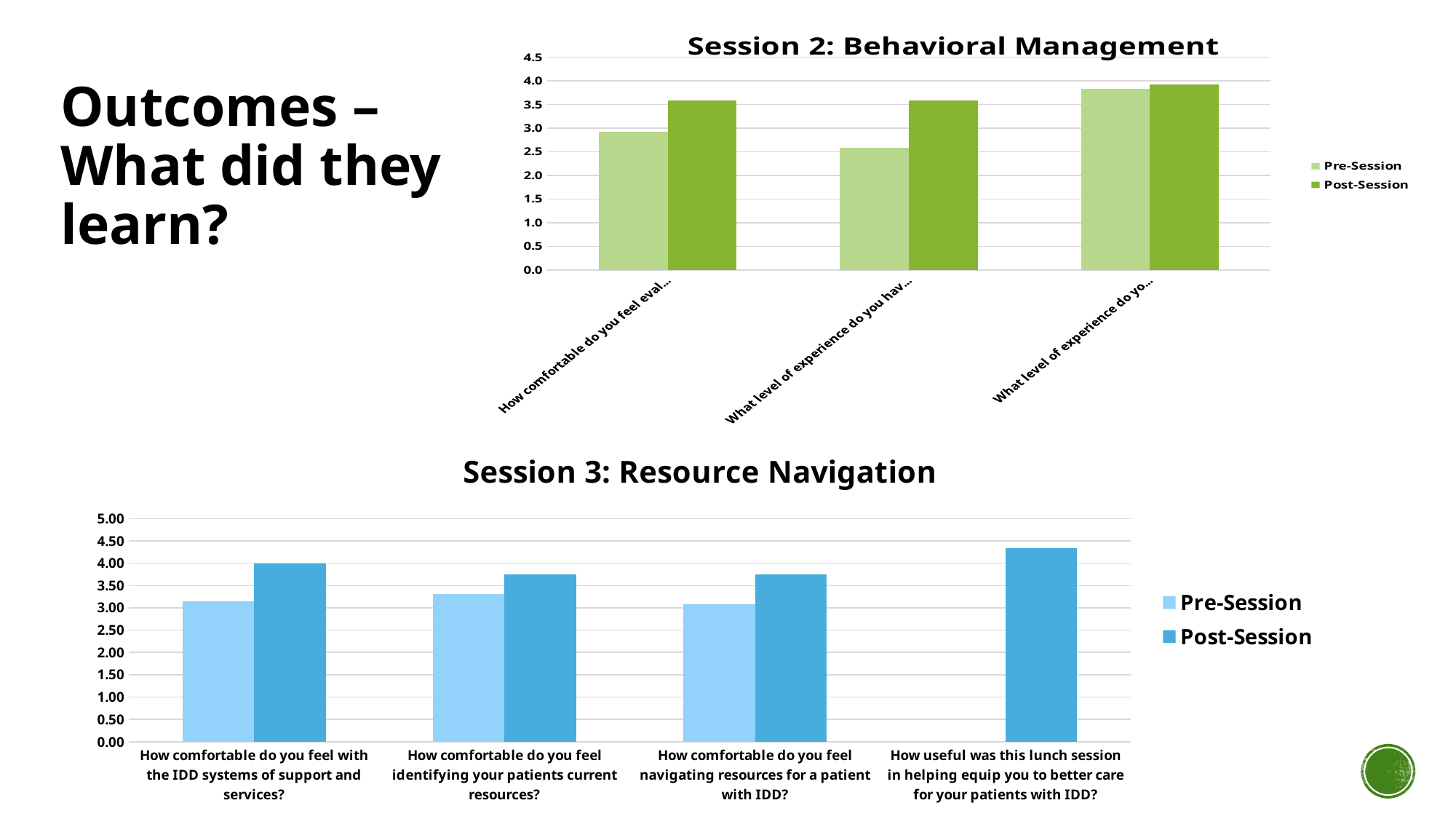
In the 'Session 2: Behavioral Management' chart, which category (by position) has the lowest Pre-Session value? the second category In the 'Session 3: Resource Navigation' chart, which legend entry is shown in the darker blue colour? Post-Session In the 'Session 2: Behavioral Management' chart, which category (by position) has the highest Pre-Session value? the third category How many question categories are shown on the x axis of the 'Session 2: Behavioral Management' chart? 3 In the 'Session 2: Behavioral Management' chart, is the Pre-Session value for the second category greater or less than 3.0? less How many series does the legend of the 'Session 2: Behavioral Management' chart list? 2 How many question categories are shown on the x axis of the 'Session 3: Resource Navigation' chart? 4 In the 'Session 3: Resource Navigation' chart, is the Post-Session value for 'How useful was this lunch session in helping equip you to better care for your patients with IDD?' greater or less than 4.00? greater In the 'Session 3: Resource Navigation' chart, is the Pre-Session value for 'How comfortable do you feel with the IDD systems of support and services?' greater or less than 3.50? less In the 'Session 3: Resource Navigation' chart, for 'How comfortable do you feel identifying your patients current resources?', which is larger: the Pre-Session or the Post-Session value? Post-Session What kind of chart is the 'Session 3: Resource Navigation' chart? bar chart In the 'Session 3: Resource Navigation' chart, which category has the highest Post-Session value? How useful was this lunch session in helping equip you to better care for your patients with IDD?